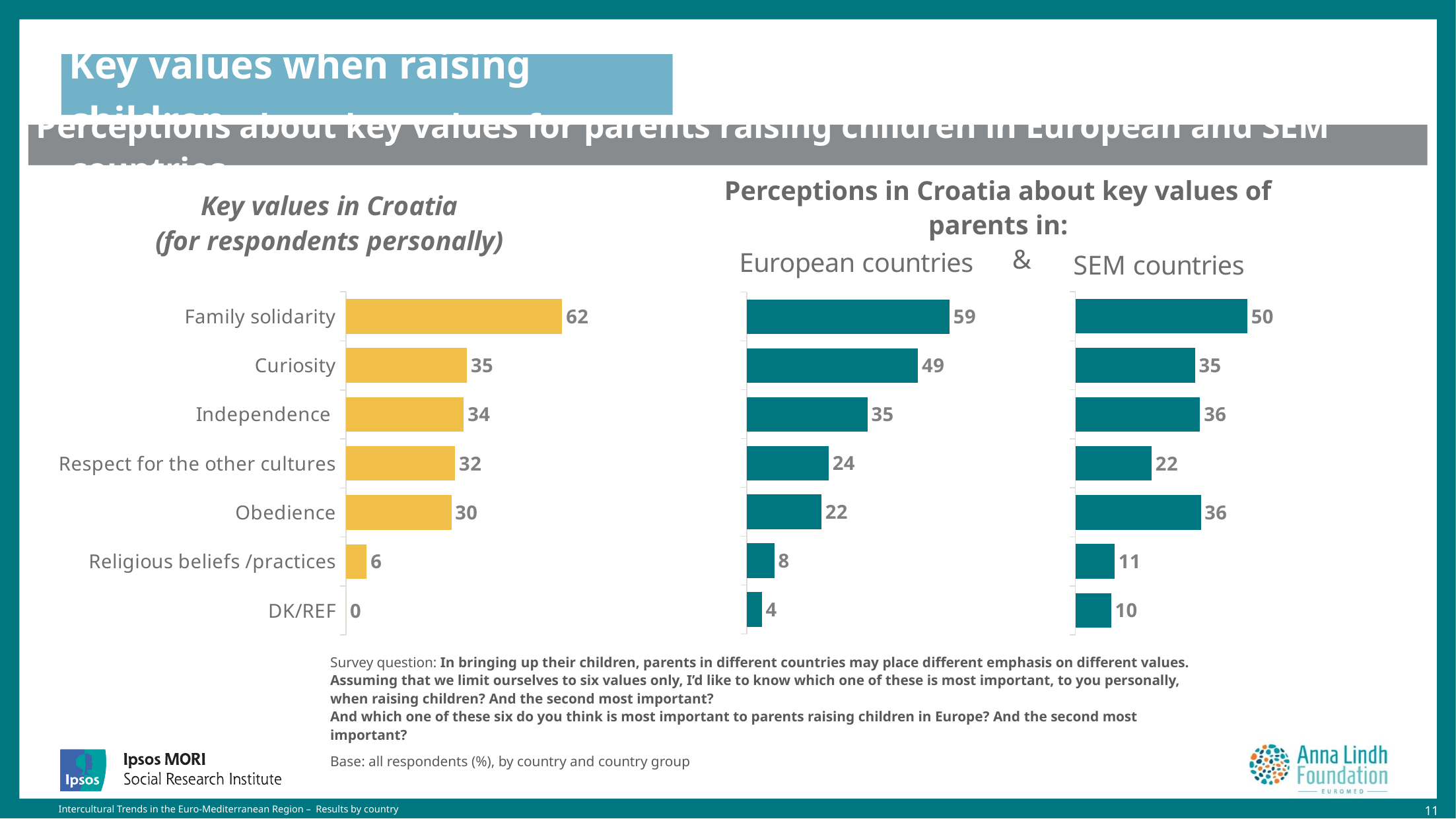
How many categories are shown in the 'Key values in Croatia (for respondents personally)' chart? 7 What colour are the bars in the 'Key values in Croatia (for respondents personally)' chart? Yellow In the 'Key values in Croatia (for respondents personally)' chart, what is the value for Obedience? 30 In the 'SEM countries' chart, which category has the highest value? Family solidarity In the 'Key values in Croatia (for respondents personally)' chart, what is the difference between Family solidarity and Curiosity? 27 In the 'European countries' chart, which category has the lowest value? DK/REF In the 'Key values in Croatia (for respondents personally)' chart, what is the value for Family solidarity? 62 Which is larger: the value for Obedience in the 'European countries' chart or in the 'SEM countries' chart? SEM countries What type of chart is the 'Key values in Croatia (for respondents personally)' chart? Bar chart